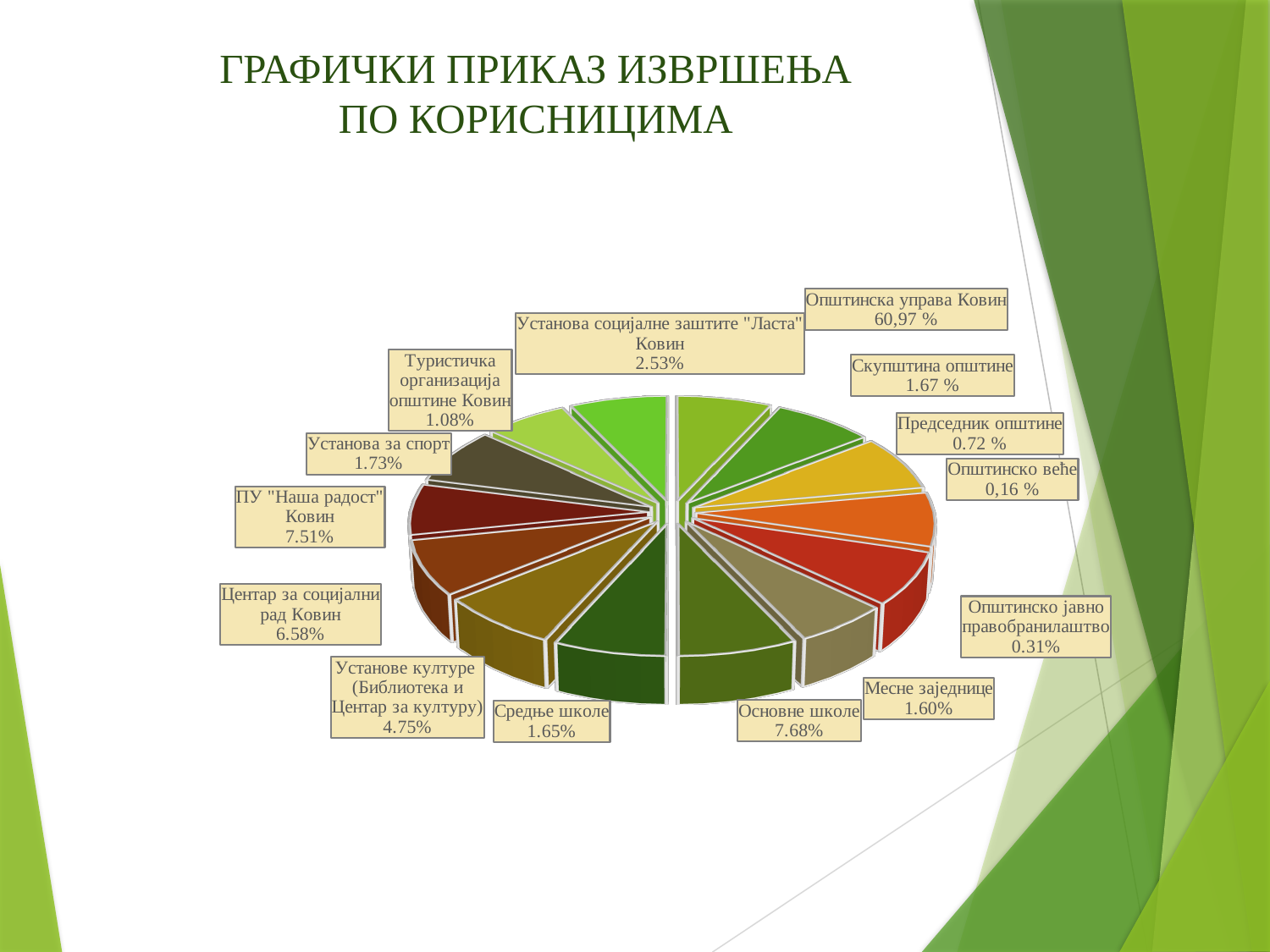
What percentage is shown for Установа социјалне заштите "Ласта" Ковин? 2.53% What is the difference between the percentages for Центар за социјални рад Ковин and Установе културе (Библиотека и Центар за културу)? 1.83% Which category has the highest percentage? Општинска управа Ковин How many categories are labelled on the pie chart? 14 What kind of chart is shown on the slide? pie chart What percentage is shown for Општинска управа Ковин? 60,97 % What is the title of the slide containing the chart? ГРАФИЧКИ ПРИКАЗ ИЗВРШЕЊА ПО КОРИСНИЦИМА Which category has the lowest percentage? Општинско веће Which has a larger percentage, Основне школе or ПУ "Наша радост" Ковин? Основне школе What percentage is shown for Основне школе? 7.68% What percentage is shown for Општинско јавно правобранилаштво? 0.31% What percentage is shown for Установе културе (Библиотека и Центар за културу)? 4.75%